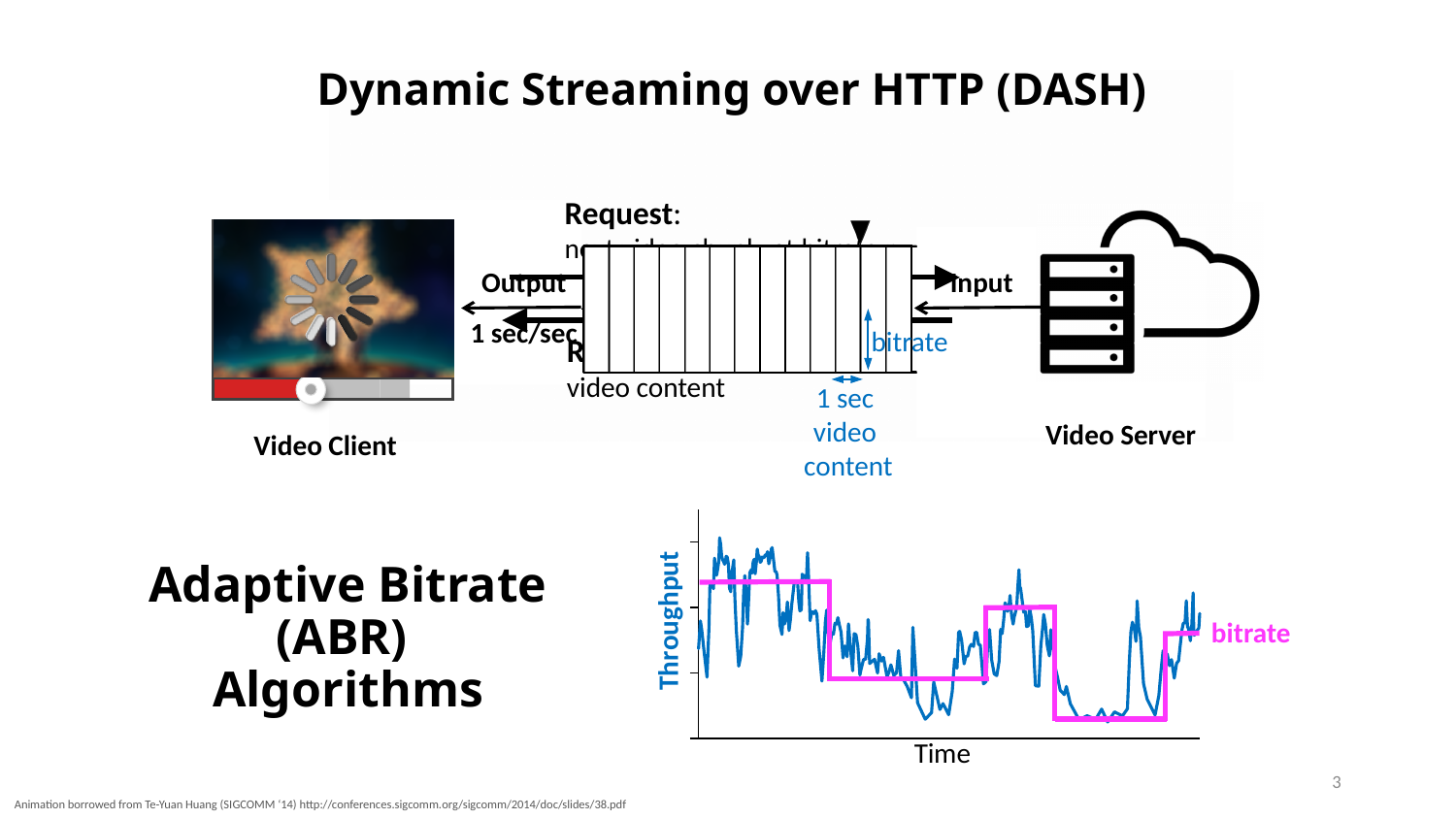
How many lines are plotted on the Throughput vs Time chart? 2 What is the label on the horizontal axis of the chart? Time On the chart, does the magenta bitrate line start at its highest level or its lowest level at the left of the time axis? highest level On the chart, which line is drawn as a step function: the blue line or the magenta line? the magenta line What kind of chart is shown at the bottom of the slide? line chart What is the label on the vertical axis of the chart? Throughput